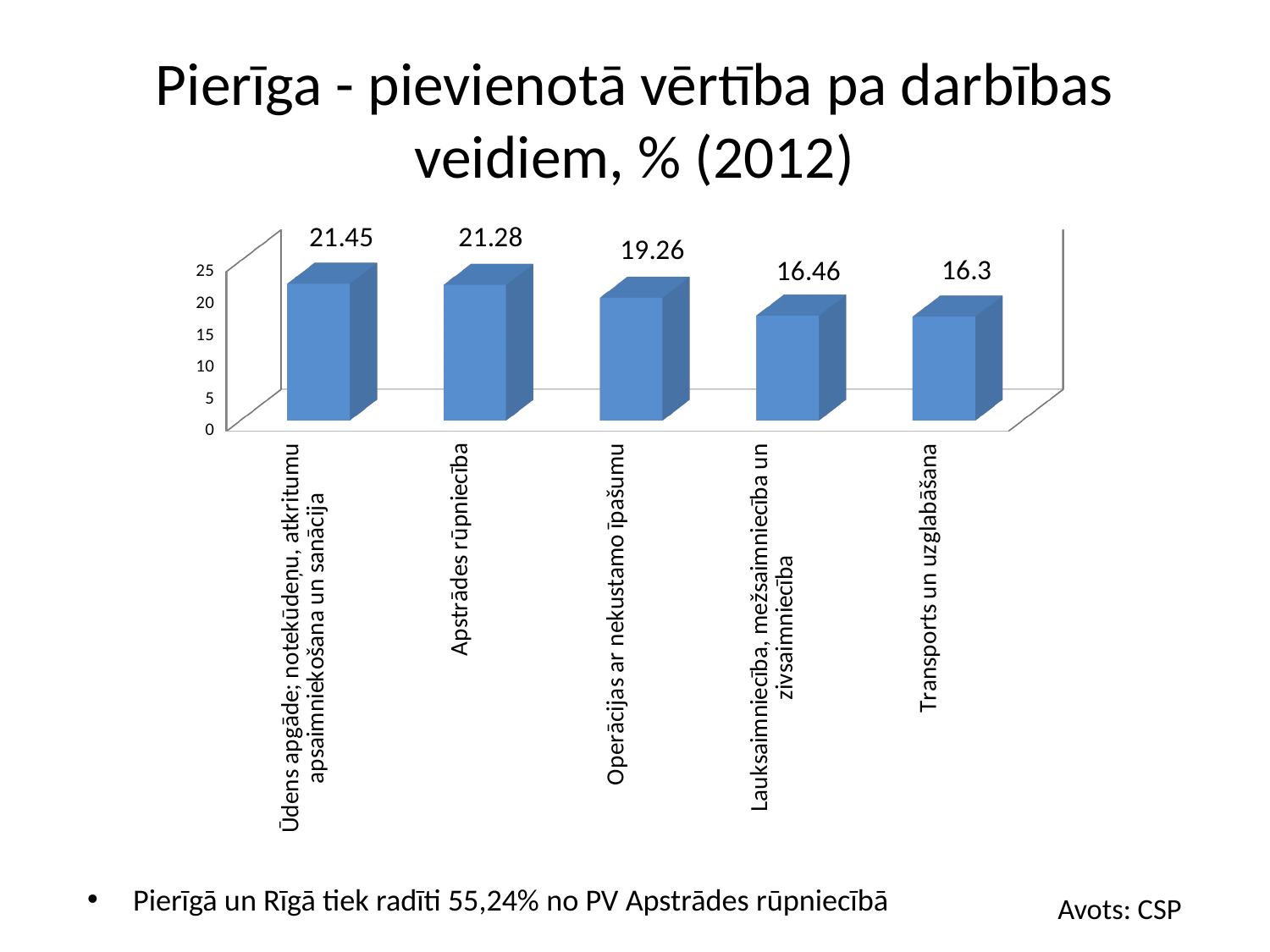
Is the value for Transports un uzglabāšana greater or less than 20? less What is the value for Apstrādes rūpniecība? 21.28 Which category has the highest value? Ūdens apgāde; notekūdeņu, atkritumu apsaimniekošana un sanācija What is the title of the chart? Pierīga - pievienotā vērtība pa darbības veidiem, % (2012) What is the value for Operācijas ar nekustamo īpašumu? 19.26 What is the value for Lauksaimniecība, mežsaimniecība un zivsaimniecība? 16.46 Which category has the lowest value? Transports un uzglabāšana What kind of chart is shown on the slide? bar chart What is the difference between the values for Apstrādes rūpniecība and Operācijas ar nekustamo īpašumu? 2.02 Which is larger: the value for Operācijas ar nekustamo īpašumu or the value for Lauksaimniecība, mežsaimniecība un zivsaimniecība? Operācijas ar nekustamo īpašumu How many categories are shown in the chart? 5 What is the value for Transports un uzglabāšana? 16.3